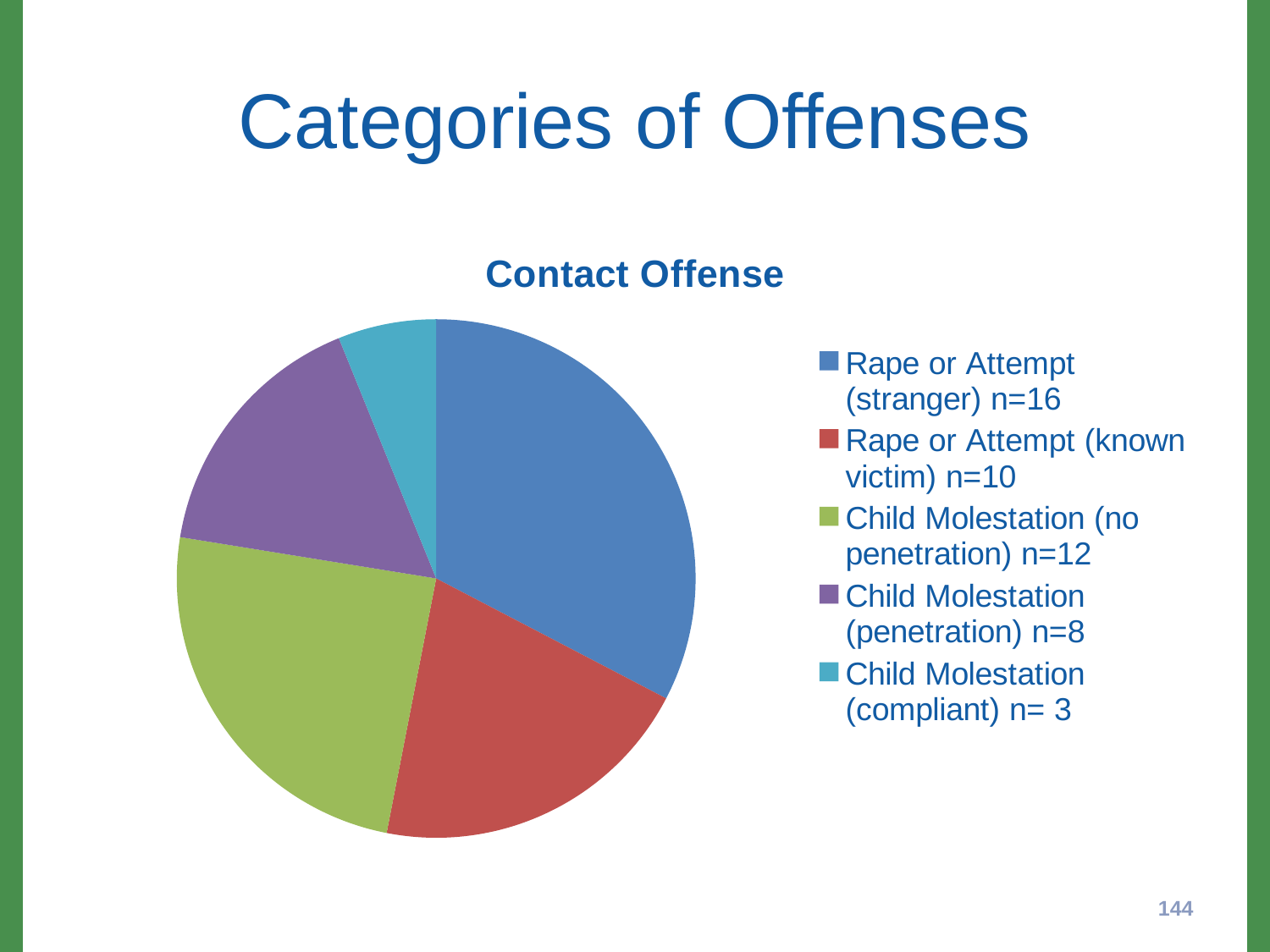
What kind of chart is shown on the slide? Pie chart What is the n value for Rape or Attempt (stranger)? n=16 What is the total n across all five categories in the pie chart? 49 Which category has the largest slice of the pie? Rape or Attempt (stranger) Which is larger: Rape or Attempt (known victim) or Child Molestation (no penetration)? Child Molestation (no penetration) What is the title of the chart? Contact Offense What is the difference between the n values for Rape or Attempt (stranger) and Child Molestation (penetration)? 8 How many categories does the pie chart have? 5 What is the n value for Child Molestation (compliant)? n= 3 What is the n value for Child Molestation (no penetration)? n=12 Which colour represents Child Molestation (penetration) in the pie chart? Purple Which category has the smallest slice of the pie? Child Molestation (compliant)